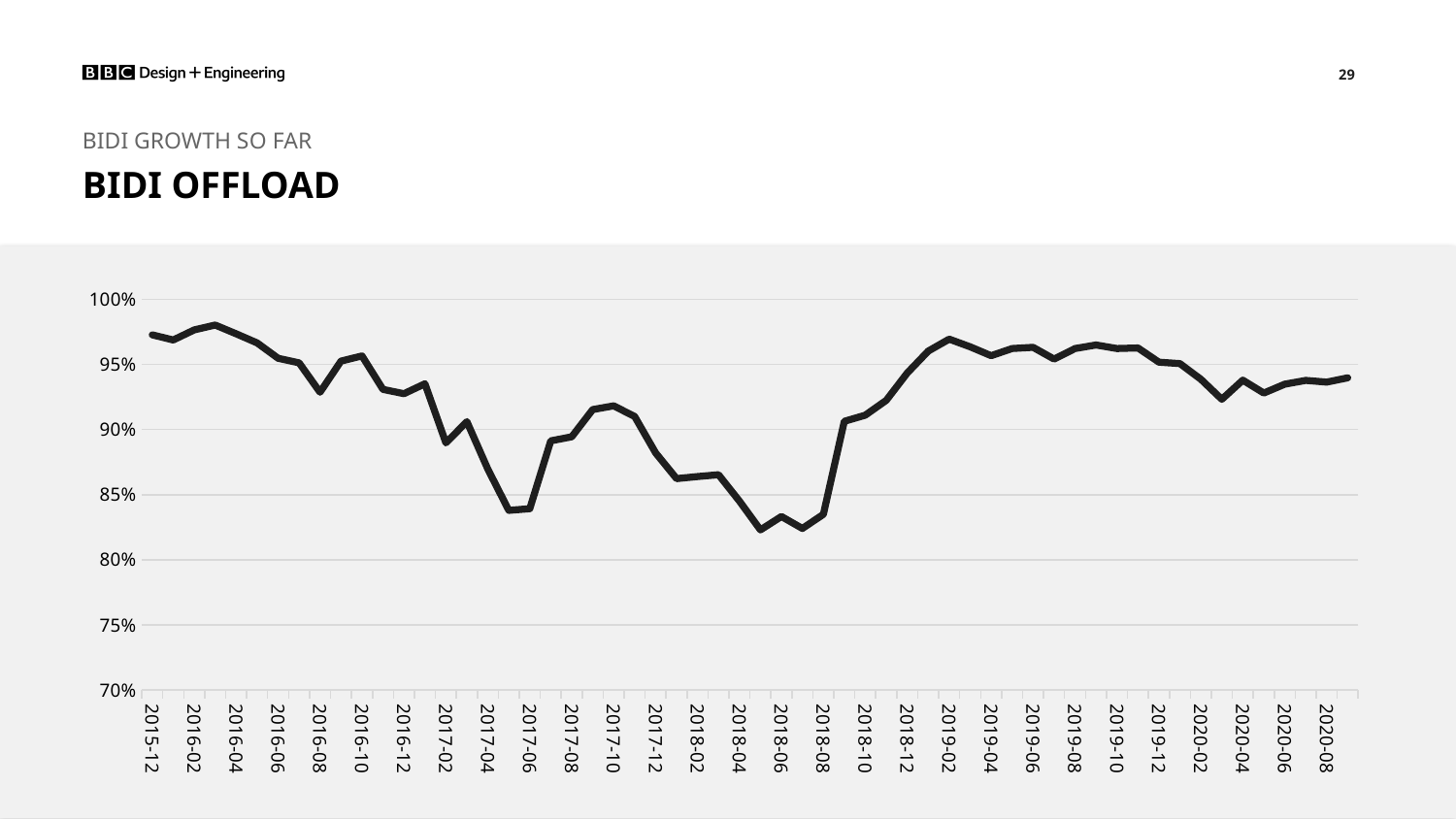
Is the value for 2018-02 greater or less than 90%? less Is the value for 2015-12 greater or less than 95%? greater Does the line rise or fall between 2018-08 and 2019-02? rise What are the lowest and highest values shown on the y axis? 70% and 100% What kind of chart is shown on the slide? line chart Is the value for 2020-08 greater or less than 90%? greater What is the title of the chart? BIDI OFFLOAD In which year does the line reach its lowest point? 2018 Which is larger, the value for 2017-06 or the value for 2019-02? 2019-02 Which is larger, the value for 2015-12 or the value for 2018-04? 2015-12